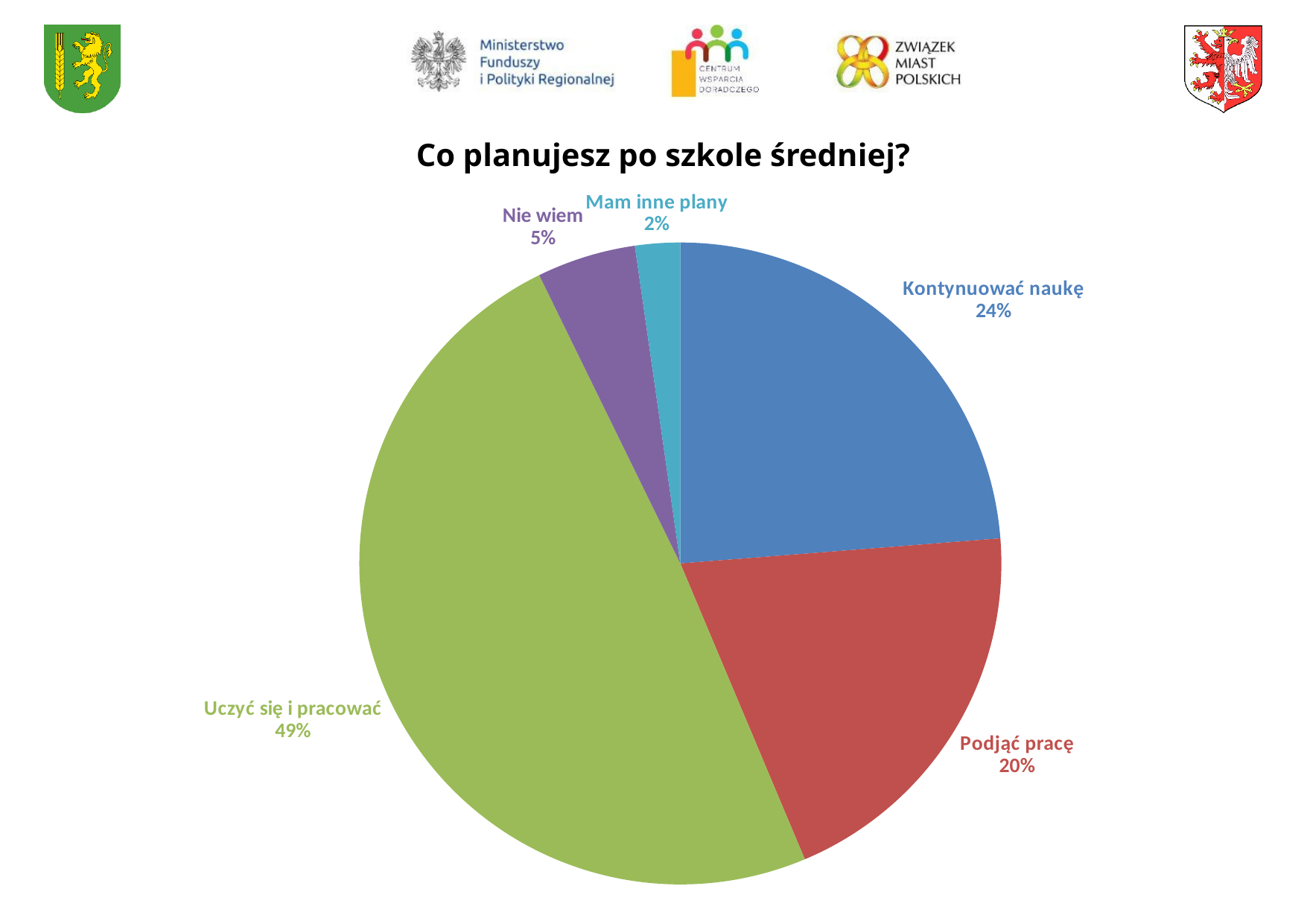
What is the value shown for "Kontynuować naukę"? 24% What share of the pie does "Uczyć się i pracować" have? 49% What kind of chart is shown on the slide? Pie chart What is the value shown for "Mam inne plany"? 2% How many categories are shown in the pie chart? 5 What is the difference in percentage points between "Kontynuować naukę" and "Podjąć pracę"? 4 Which category has the largest slice of the pie? Uczyć się i pracować What is the value shown for "Podjąć pracę"? 20% What is the title of the chart? Co planujesz po szkole średniej? What is the value shown for "Nie wiem"? 5% Which category has the smallest slice of the pie? Mam inne plany Which is larger, "Nie wiem" or "Mam inne plany"? Nie wiem